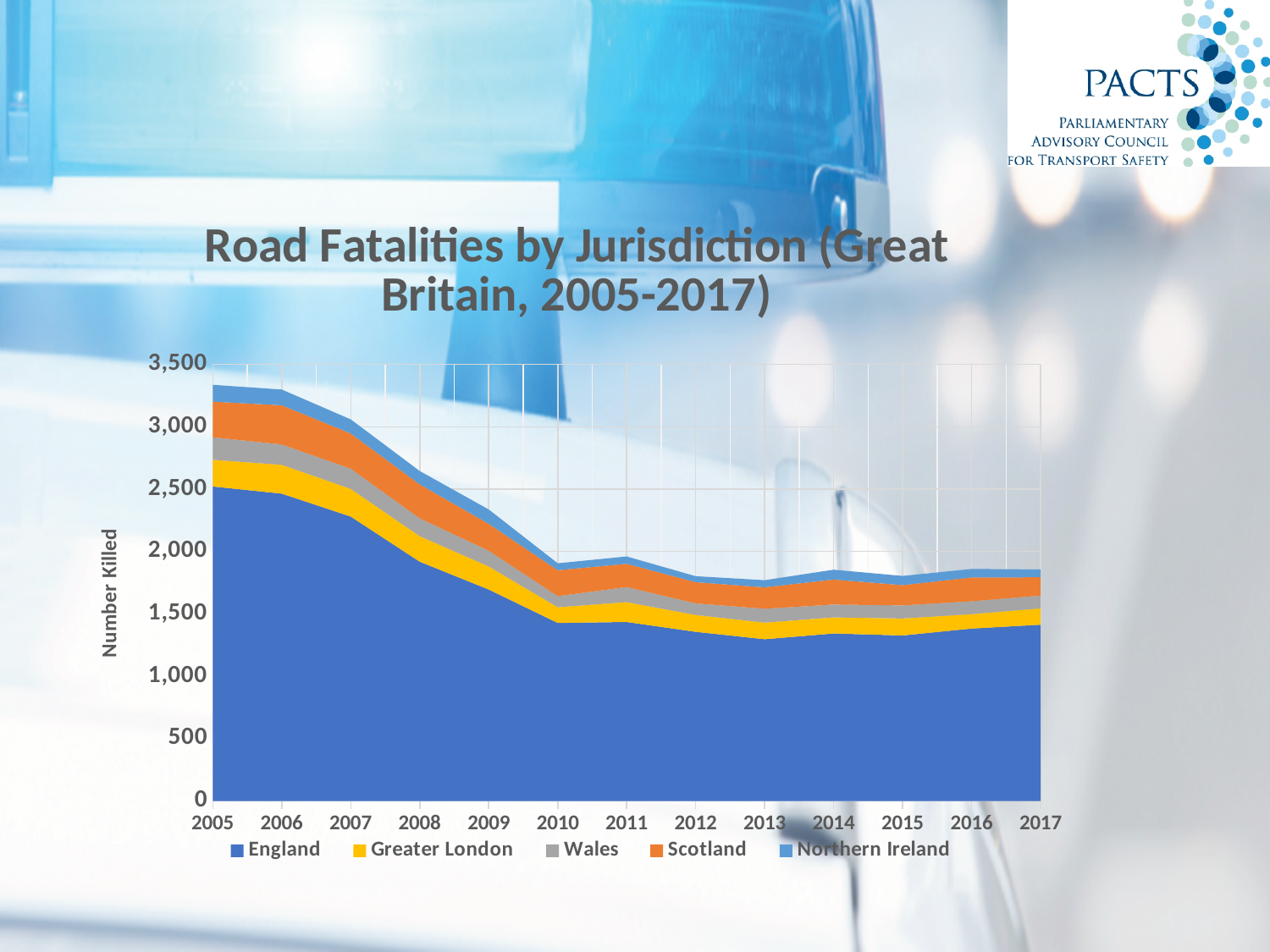
What is the label on the y axis? Number Killed Is the total number killed in 2005 greater or less than 3,000? greater What is the title of the chart? Road Fatalities by Jurisdiction (Great Britain, 2005-2017) How many series does the legend list? 5 How many years are plotted along the x axis? 13 Is the total number killed in 2017 greater or less than 2,000? less Which is larger, the value for England in 2005 or in 2017? 2005 What kind of chart is shown on the slide? Stacked area chart Is the value for England in 2005 greater or less than 2,000? greater In which year is the total number killed highest? 2005 Does the total number killed rise or fall from 2005 to 2017? Fall